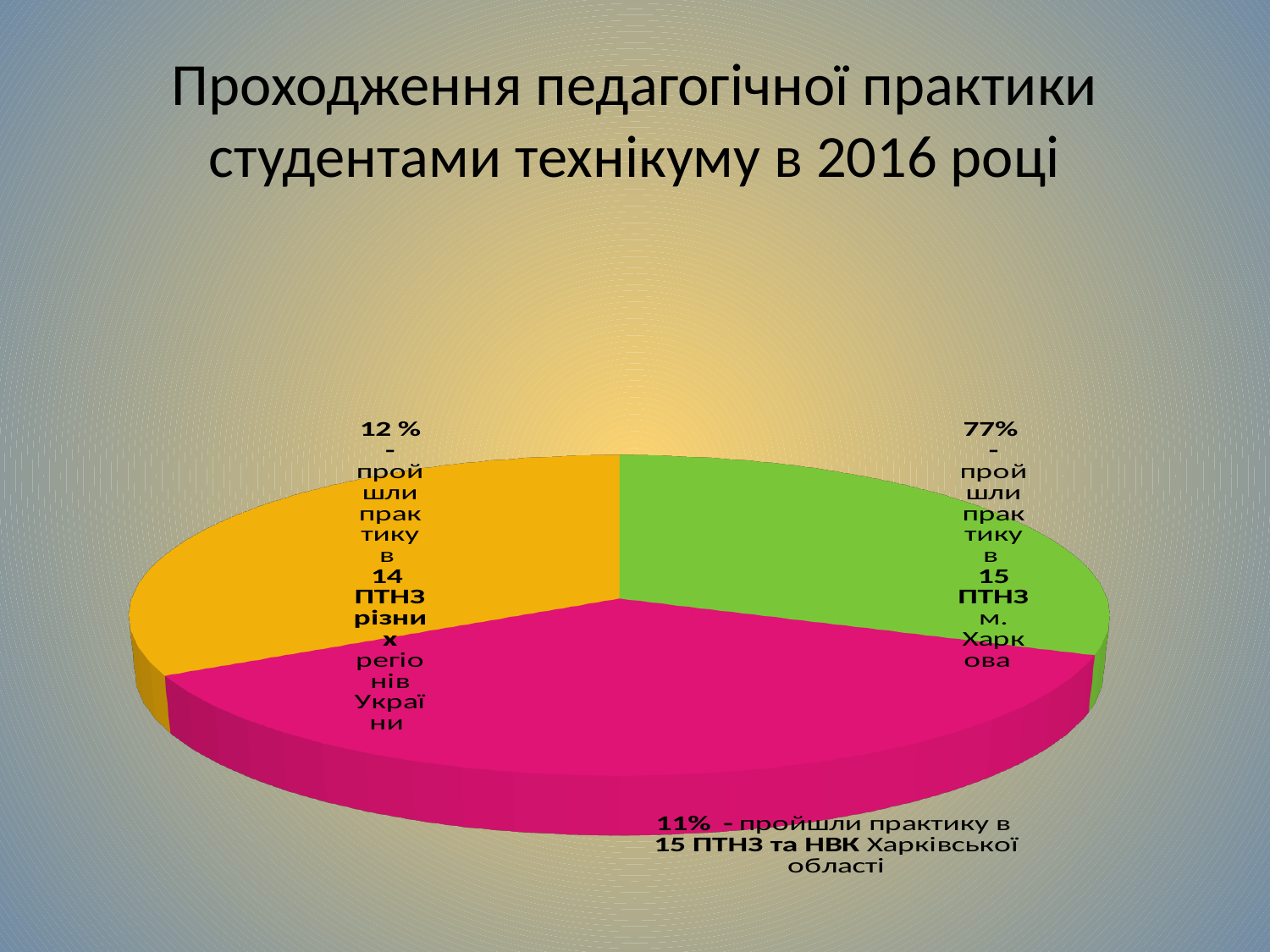
What kind of chart is shown on the slide? pie chart How many slices does the pie chart have? 3 According to the label, what percentage of students completed their practice in 14 ПТНЗ of different regions of Ukraine? 12 % According to the label, what percentage of students completed their practice in 15 ПТНЗ та НВК of Kharkiv oblast (Харківської області)? 11% In how many ПТНЗ of different regions of Ukraine did students complete their practice, according to the label? 14 According to the printed labels, which share is larger: practice in 15 ПТНЗ м. Харкова or practice in 15 ПТНЗ та НВК Харківської області? 15 ПТНЗ м. Харкова (77%) What is the title of the chart slide? Проходження педагогічної практики студентами технікуму в 2016 році According to the label, what percentage of students completed their practice in 15 ПТНЗ of the city of Kharkiv (м. Харкова)? 77% Which year does the slide title refer to? 2016 In how many ПТНЗ of the city of Kharkiv did students complete their practice, according to the label? 15 What is the difference in percentage points between the labelled share for 15 ПТНЗ м. Харкова (77%) and the share for 14 ПТНЗ різних регіонів України (12 %)? 65% What is the difference in percentage points between the labelled share for 14 ПТНЗ різних регіонів України (12 %) and the share for 15 ПТНЗ та НВК Харківської області (11%)? 1%